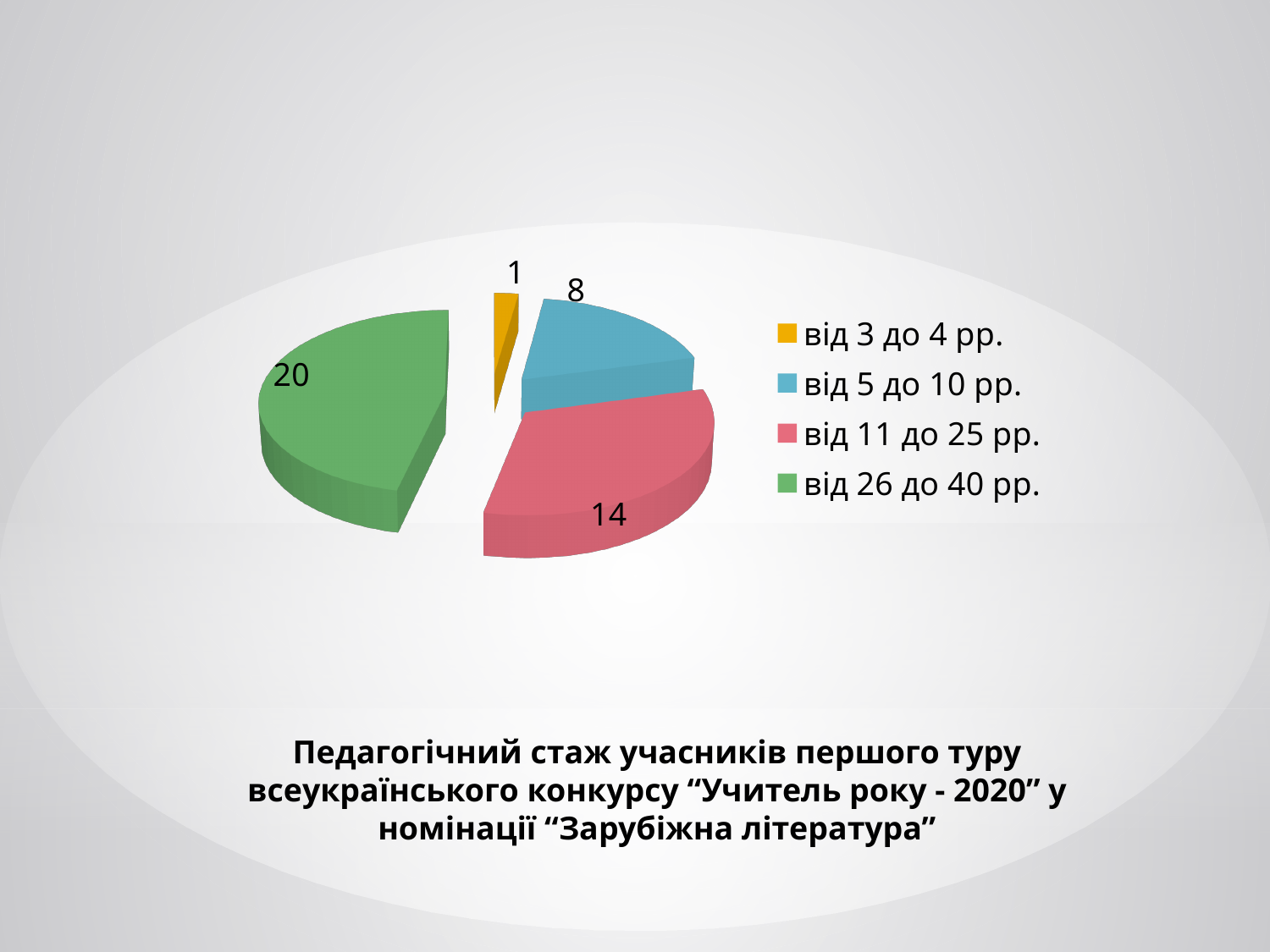
Which category has the largest slice of the pie? від 26 до 40 рр. What is the value for the category "від 26 до 40 рр."? 20 What is the difference between the values for "від 26 до 40 рр." and "від 11 до 25 рр."? 6 What colour is the slice for "від 26 до 40 рр."? Green What is the difference between the values for "від 5 до 10 рр." and "від 3 до 4 рр."? 7 What is the value for the category "від 3 до 4 рр."? 1 What is the value for the category "від 5 до 10 рр."? 8 How many categories does the pie chart have? 4 Which is larger: the value for "від 11 до 25 рр." or the value for "від 5 до 10 рр."? від 11 до 25 рр. Which category has the smallest slice of the pie? від 3 до 4 рр. What is the value for the category "від 11 до 25 рр."? 14 What type of chart is shown on the slide? Pie chart